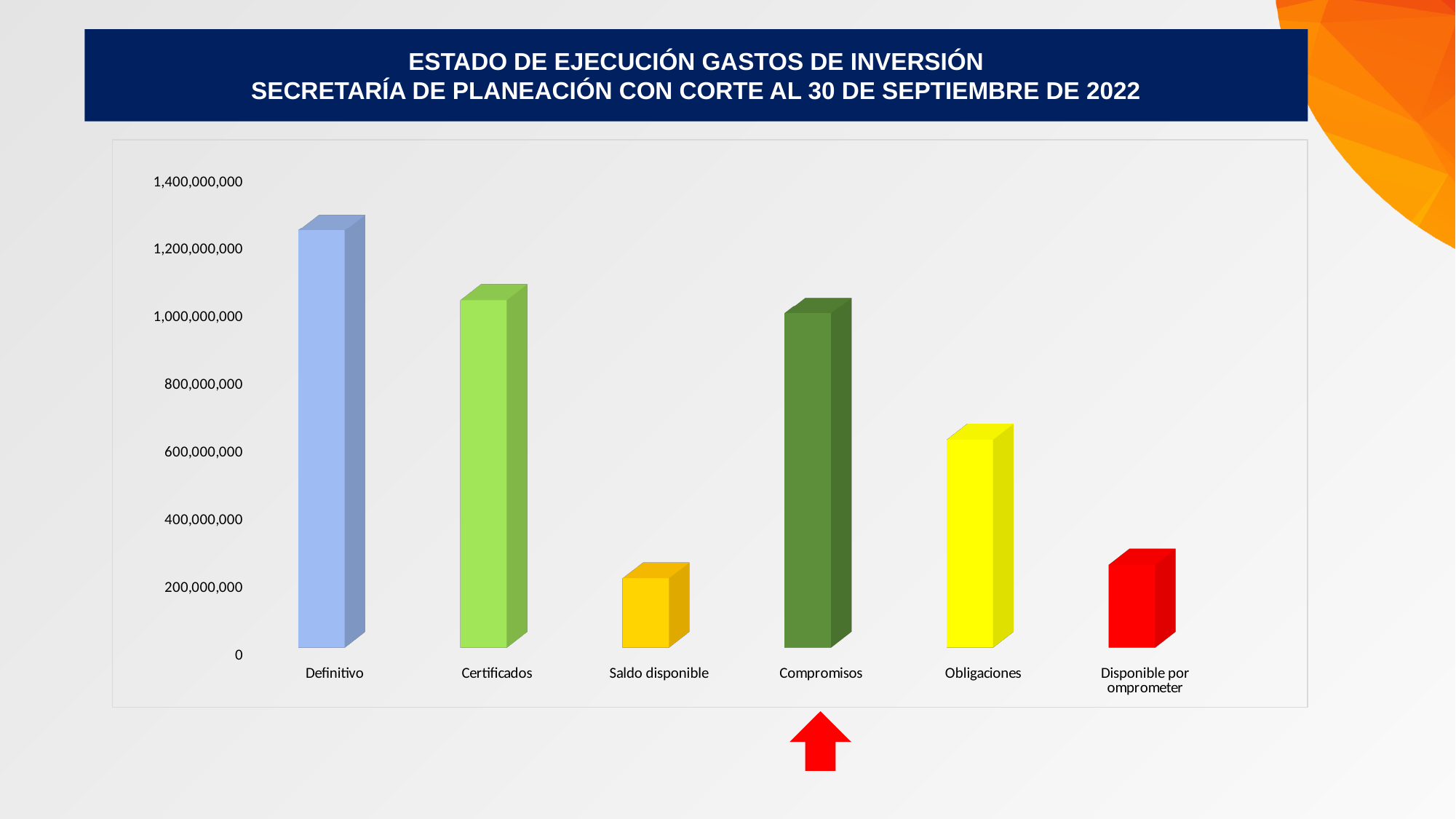
Which category does the red arrow below the chart point to? Compromisos How many categories are plotted on the chart? 6 What kind of chart is shown on the slide? Bar chart Which is larger, the value for Obligaciones or the value for Compromisos? Compromisos Which category has the highest value? Definitivo Is the value for Definitivo greater or less than 1,200,000,000? greater Is the value for Disponible por comprometer greater or less than 200,000,000? greater Is the value for Obligaciones greater or less than 800,000,000? less Which is larger, the value for Certificados or the value for Compromisos? Certificados Which category has the lowest value? Saldo disponible